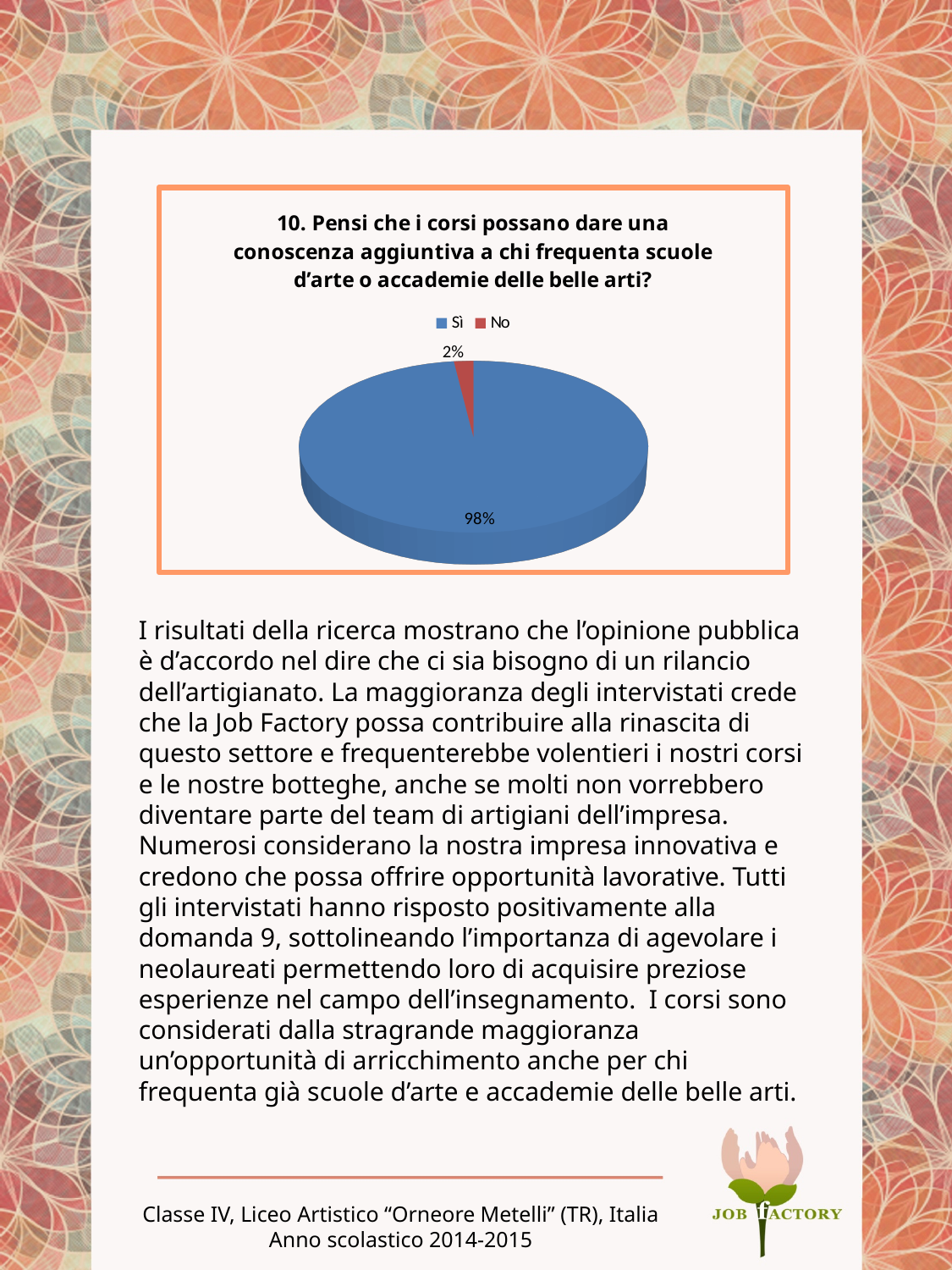
How many slices does the pie chart have? 2 Which is larger, the "Sì" slice or the "No" slice? Sì What share of the pie does "Sì" represent? 98% What is the difference in percentage points between the "Sì" and "No" slices? 96 What question number is shown in the chart title? 10 Which slice is the smallest? No What colour is the "No" slice? red Which slice is the largest? Sì What kind of chart is shown on the slide? pie chart What share of the pie does "No" represent? 2% How many entries does the legend list? 2